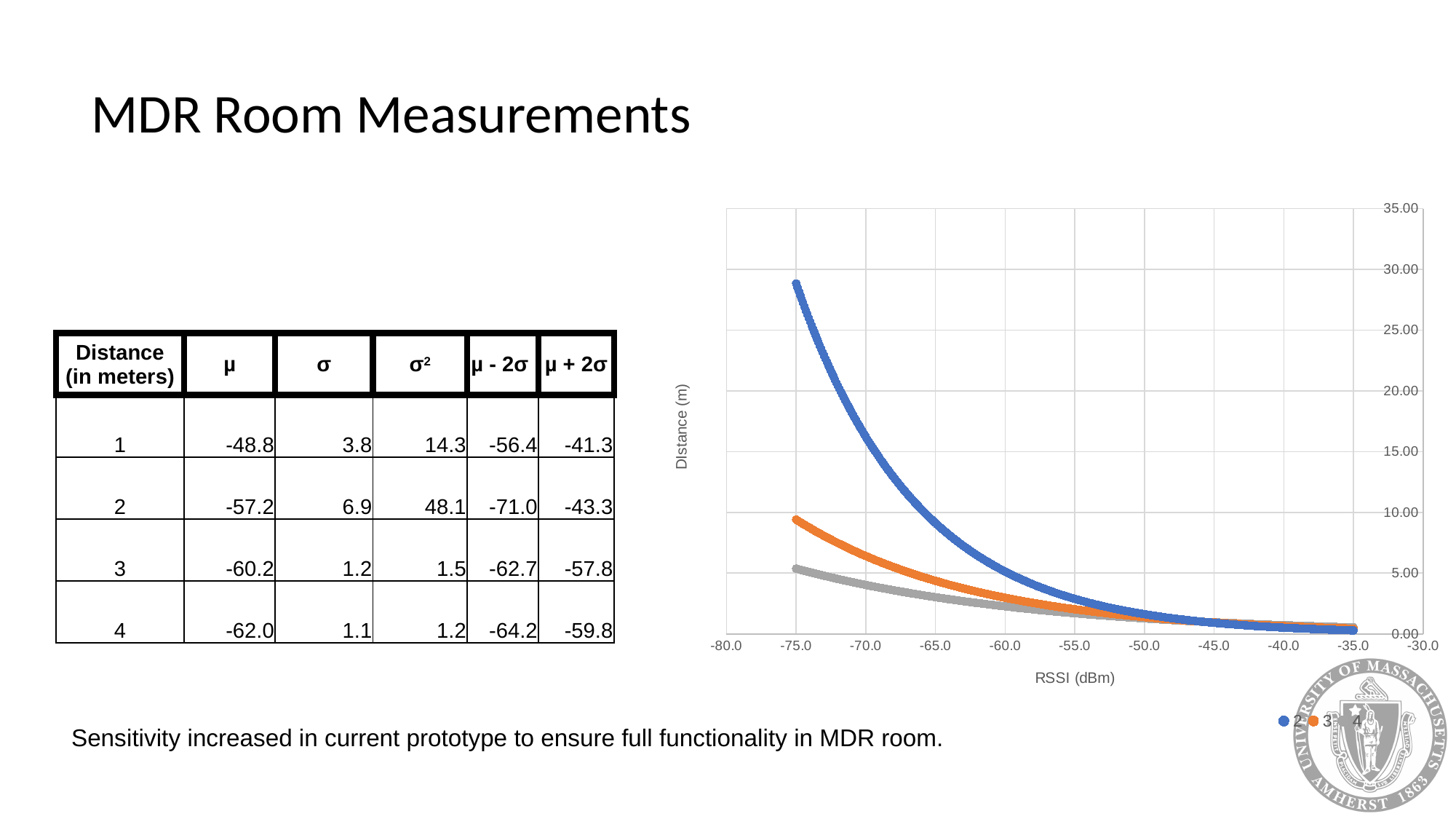
Which series has the highest distance value at an RSSI of -75.0 dBm? 2 Is the distance value for series 2 at -75.0 dBm greater or less than 25.00? greater How many series does the chart's legend list? 3 Do the distance values rise or fall as RSSI increases from -75.0 to -35.0 dBm? fall What is the label of the chart's y axis? Distance (m) At -65.0 dBm, which series has the larger distance value, series 2 or series 3? 2 Which series has the lowest distance value at an RSSI of -75.0 dBm? 4 What is the label of the chart's x axis? RSSI (dBm) Is the distance value for series 4 at -75.0 dBm greater or less than 10.00? less What kind of chart is shown on the slide? scatter chart